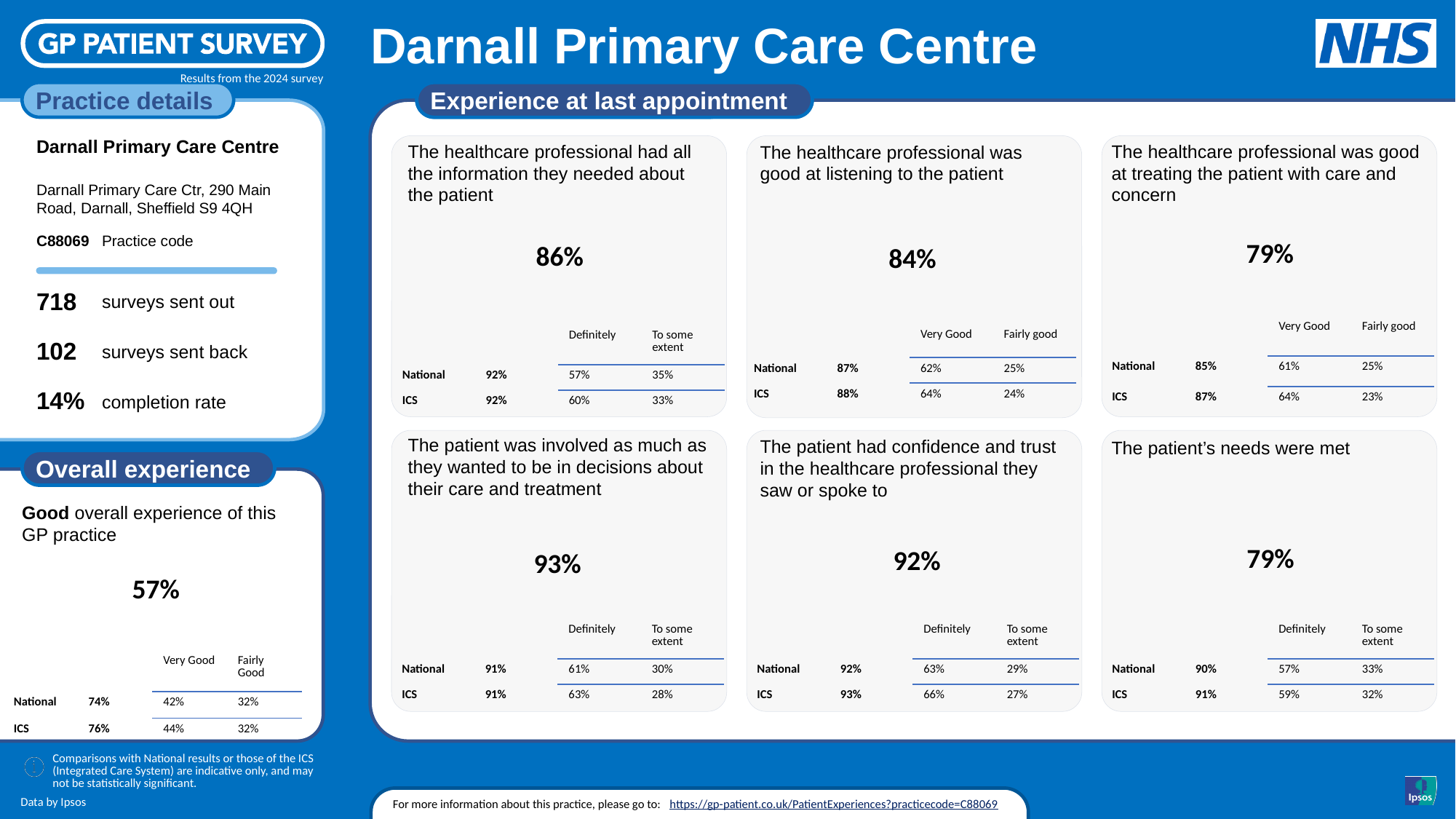
In the 'Experience at last appointment' section, what is the practice value for 'The healthcare professional had all the information they needed about the patient'? 86% In the 'Overall experience' panel, what is the ICS value for good overall experience? 76% In the 'Experience at last appointment' section, which of the six measures has the highest practice value? The patient was involved as much as they wanted to be in decisions about their care and treatment In the 'Overall experience' panel, what percentage of patients reported a good overall experience of this GP practice? 57% In the 'Experience at last appointment' section, what is the practice value for 'The healthcare professional was good at listening to the patient'? 84% How many measures are shown in the 'Experience at last appointment' section? 6 In the 'Overall experience' panel, what is the difference between the ICS value and the practice value for good overall experience? 19% In the 'Experience at last appointment' section, what is the National value for 'The patient's needs were met'? 90% In the 'Experience at last appointment' section, what is the ICS 'Very Good' value for 'The healthcare professional was good at treating the patient with care and concern'? 64% In the 'Experience at last appointment' section, is the practice value for 'The patient had confidence and trust in the healthcare professional they saw or spoke to' higher or lower than the National value? Same (92%) In the 'Overall experience' panel, what is the National value for good overall experience? 74% In the 'Experience at last appointment' section, what is the difference between the National value and the practice value for 'The healthcare professional was good at treating the patient with care and concern'? 6%